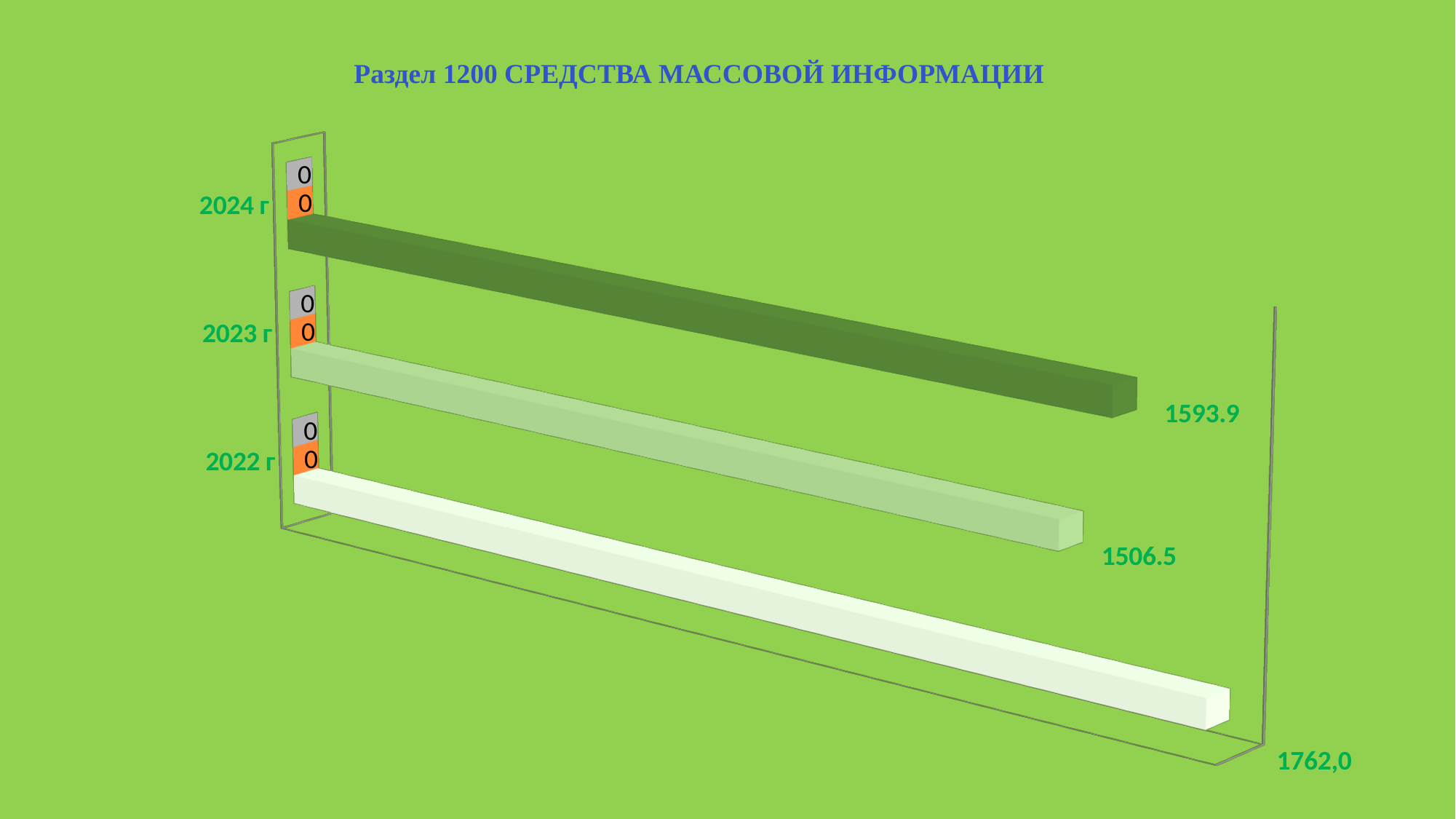
What is the value for 2023 г? 1506.5 What is the title of the chart? Раздел 1200 СРЕДСТВА МАССОВОЙ ИНФОРМАЦИИ How many years are shown on the chart? 3 Which year has the highest value? 2022 г Which is larger, the value for 2024 г or the value for 2023 г? 2024 г What is the difference between the values for 2022 г and 2023 г? 255.5 What is the difference between the values for 2024 г and 2023 г? 87.4 What is the difference between the values for 2022 г and 2024 г? 168.1 What kind of chart is shown on the slide? Bar chart Which year has the lowest value? 2023 г What is the value for 2022 г? 1762,0 What is the value for 2024 г? 1593.9